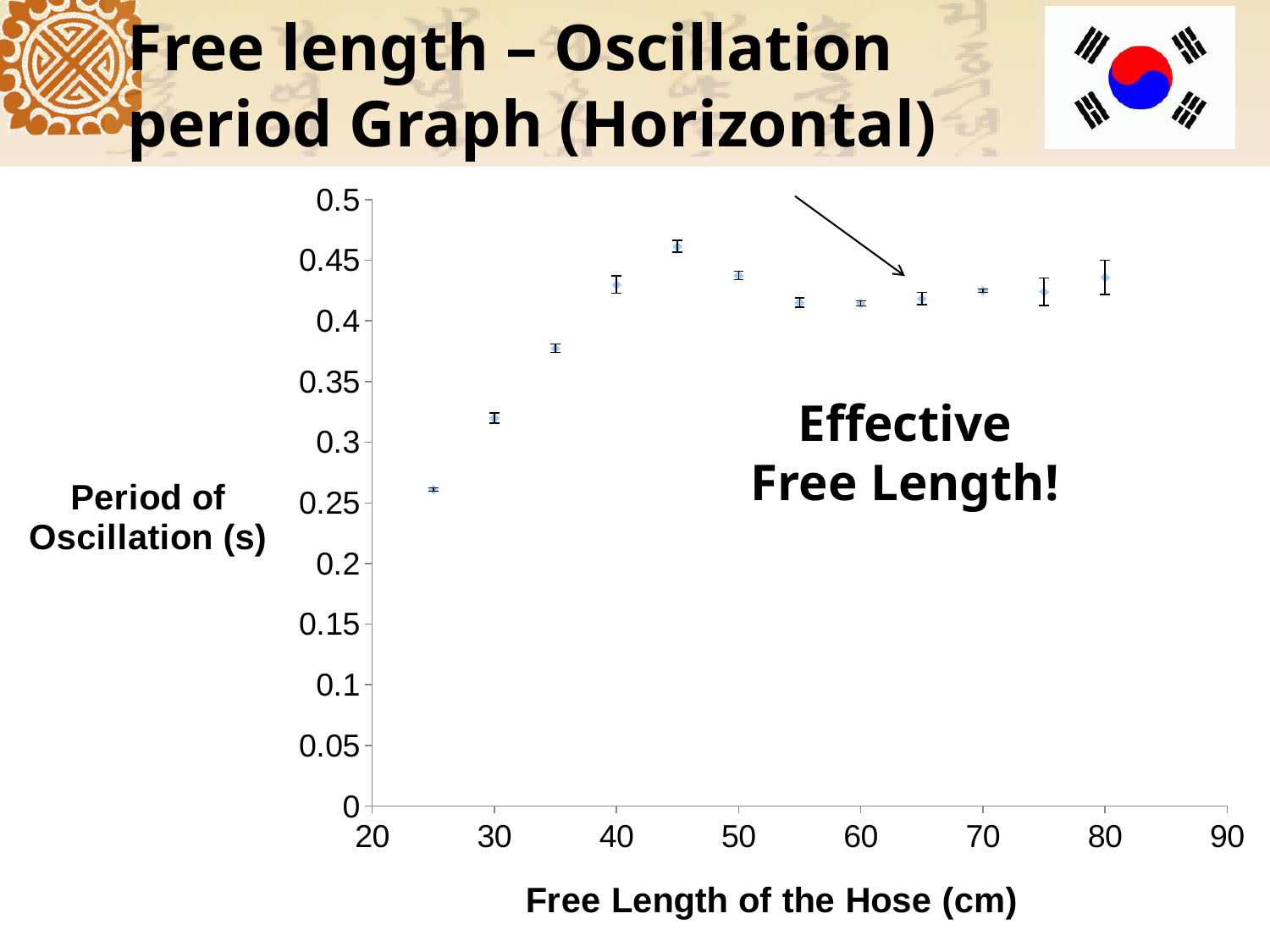
At which free length of the hose is the period of oscillation lowest? 25 cm What text does the arrow annotation on the chart point to? Effective Free Length! Is the period of oscillation at a free length of 60 cm greater or less than 0.4 s? greater What is the title of the x axis of the chart? Free Length of the Hose (cm) Is the period of oscillation at a free length of 25 cm greater or less than 0.3 s? less Is the period of oscillation at a free length of 45 cm greater or less than 0.45 s? greater Which has the larger period of oscillation: a free length of 30 cm or 40 cm? 40 cm Do the period values rise or fall as the free length increases from 25 cm to 45 cm? rise What kind of chart is shown on the slide? scatter chart At which free length of the hose is the period of oscillation highest? 45 cm How many data points are plotted on the chart? 12